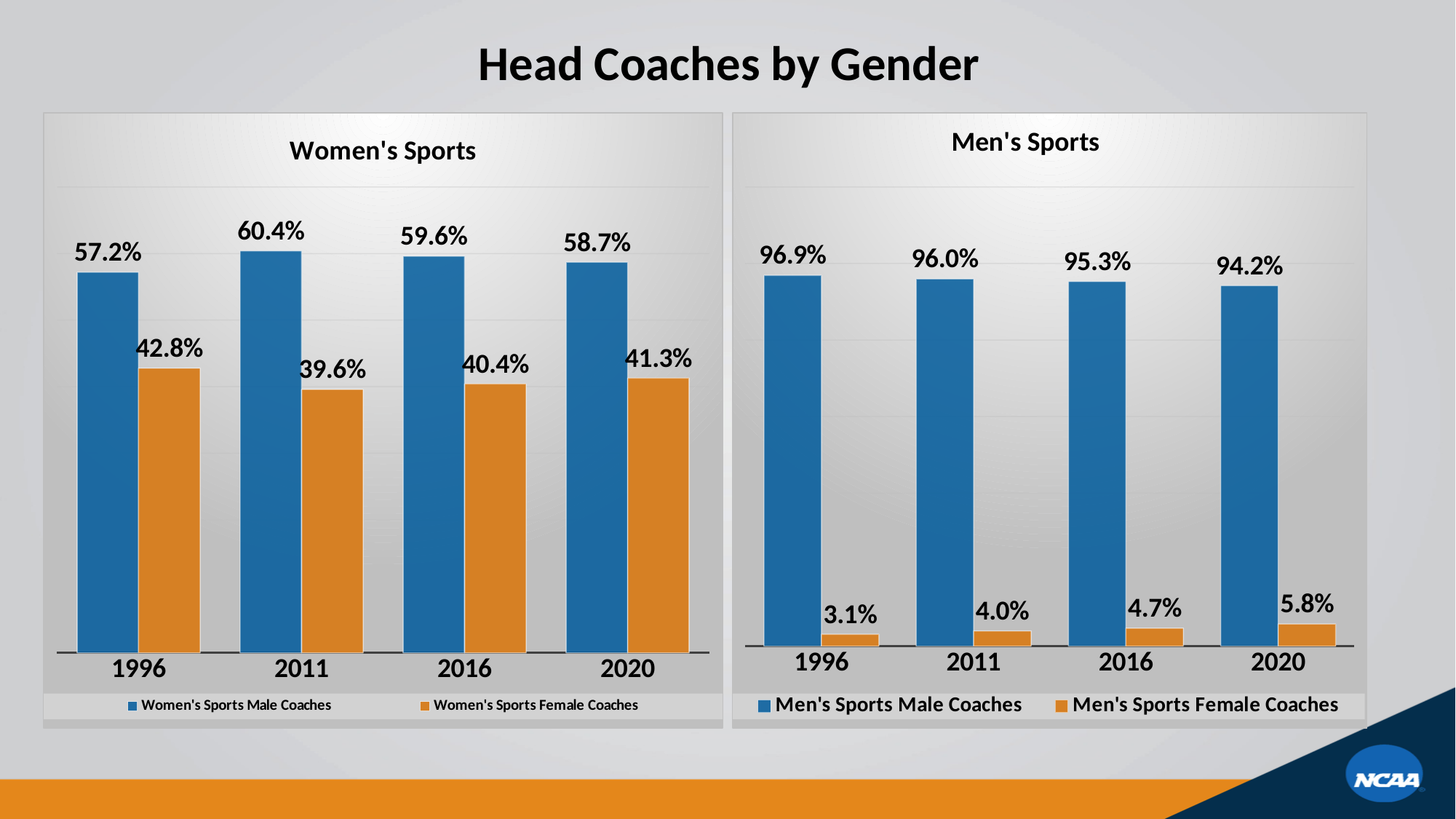
In the Men's Sports chart, which year has the lowest value for Men's Sports Female Coaches? 1996 What kind of chart is the Men's Sports chart? bar chart In the Women's Sports chart, which year has the highest value for Women's Sports Male Coaches? 2011 In the Men's Sports chart, what is the value for Men's Sports Female Coaches in 2020? 5.8% In the Men's Sports chart, what is the difference between Men's Sports Male Coaches in 1996 and in 2020? 2.7% In the Women's Sports chart, is the value for Women's Sports Female Coaches larger in 1996 or in 2011? 1996 In the Men's Sports chart, do the values for Men's Sports Male Coaches rise or fall from 1996 to 2020? fall In the Women's Sports chart, what is the difference between Women's Sports Male Coaches and Women's Sports Female Coaches in 2020? 17.4% In the Men's Sports chart, what is the value for Men's Sports Male Coaches in 2016? 95.3% How many years are shown on the x axis of the Women's Sports chart? 4 In the Women's Sports chart, what is the value for Women's Sports Female Coaches in 1996? 42.8% In the Women's Sports chart, what is the value for Women's Sports Male Coaches in 2011? 60.4%